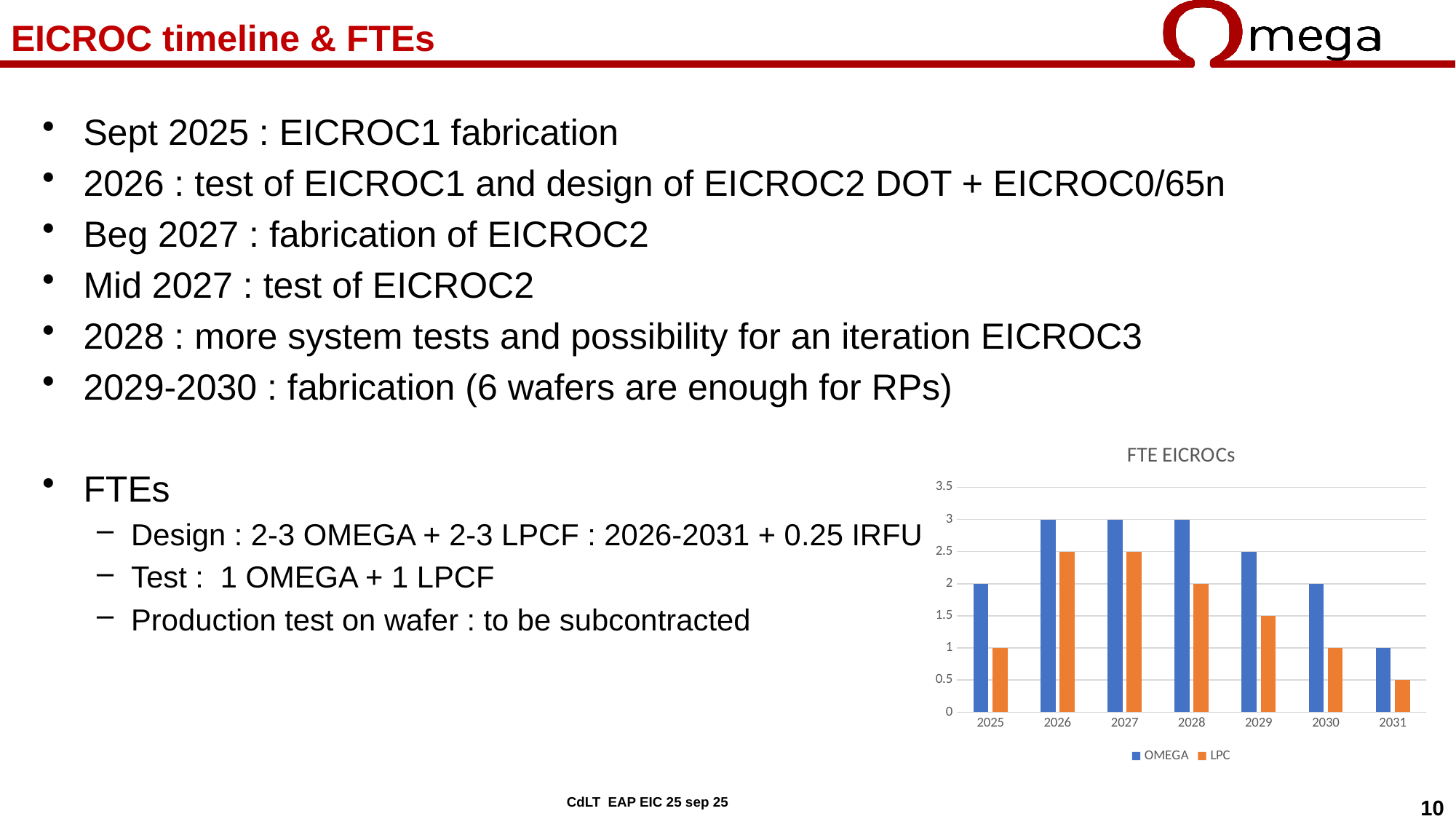
What kind of chart is shown on the slide? bar chart Which series has the larger value in 2029, OMEGA or LPC? OMEGA Which year has the lowest LPC value? 2031 Is the OMEGA value for 2030 greater or less than 2.5? less Is the LPC value for 2026 greater or less than 2? greater What is the OMEGA value for 2031? 1 What is the LPC value for 2031? 0.5 What is the title of the chart? FTE EICROCs How many series does the chart legend list? 2 What is the OMEGA value for 2025? 2 Do the OMEGA values rise or fall from 2028 to 2031? fall How many years are shown on the x axis of the chart? 7